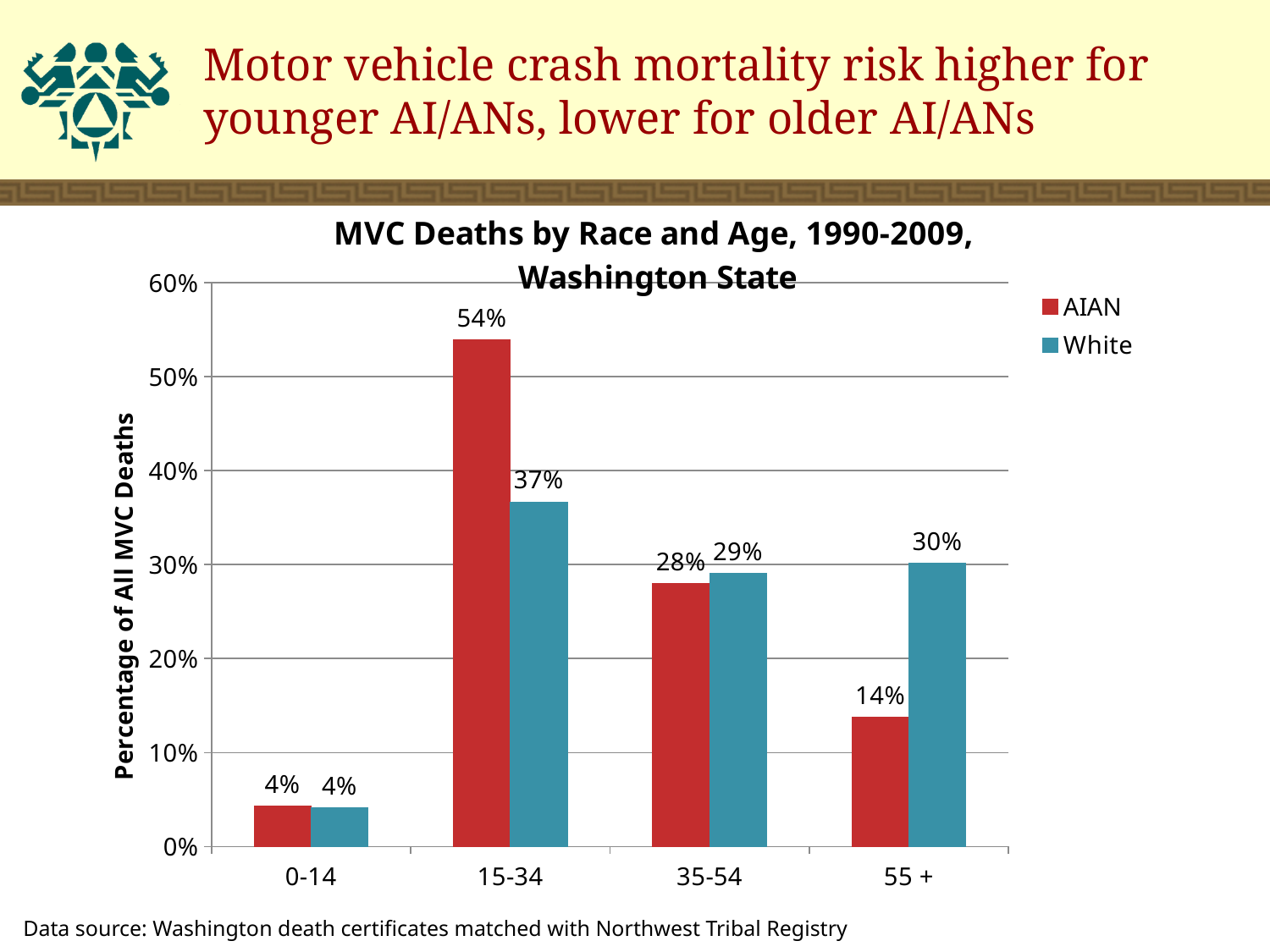
Which age group has the highest AIAN value? 15-34 What is the difference between the AIAN and White values in the 15-34 age group? 17% What is the title of the chart? MVC Deaths by Race and Age, 1990-2009, Washington State Which age group has the lowest White value? 0-14 What is the difference between the White and AIAN values in the 55 + age group? 16% What is the value for AIAN in the 55 + age group? 14% How many age groups are shown on the x axis? 4 What percentage of all MVC deaths is shown for White in the 55 + age group? 30% What percentage of all MVC deaths is shown for AIAN in the 15-34 age group? 54% What kind of chart is shown on the slide? Bar chart In the 55 + age group, which series has the larger value, AIAN or White? White How many series does the legend list? 2